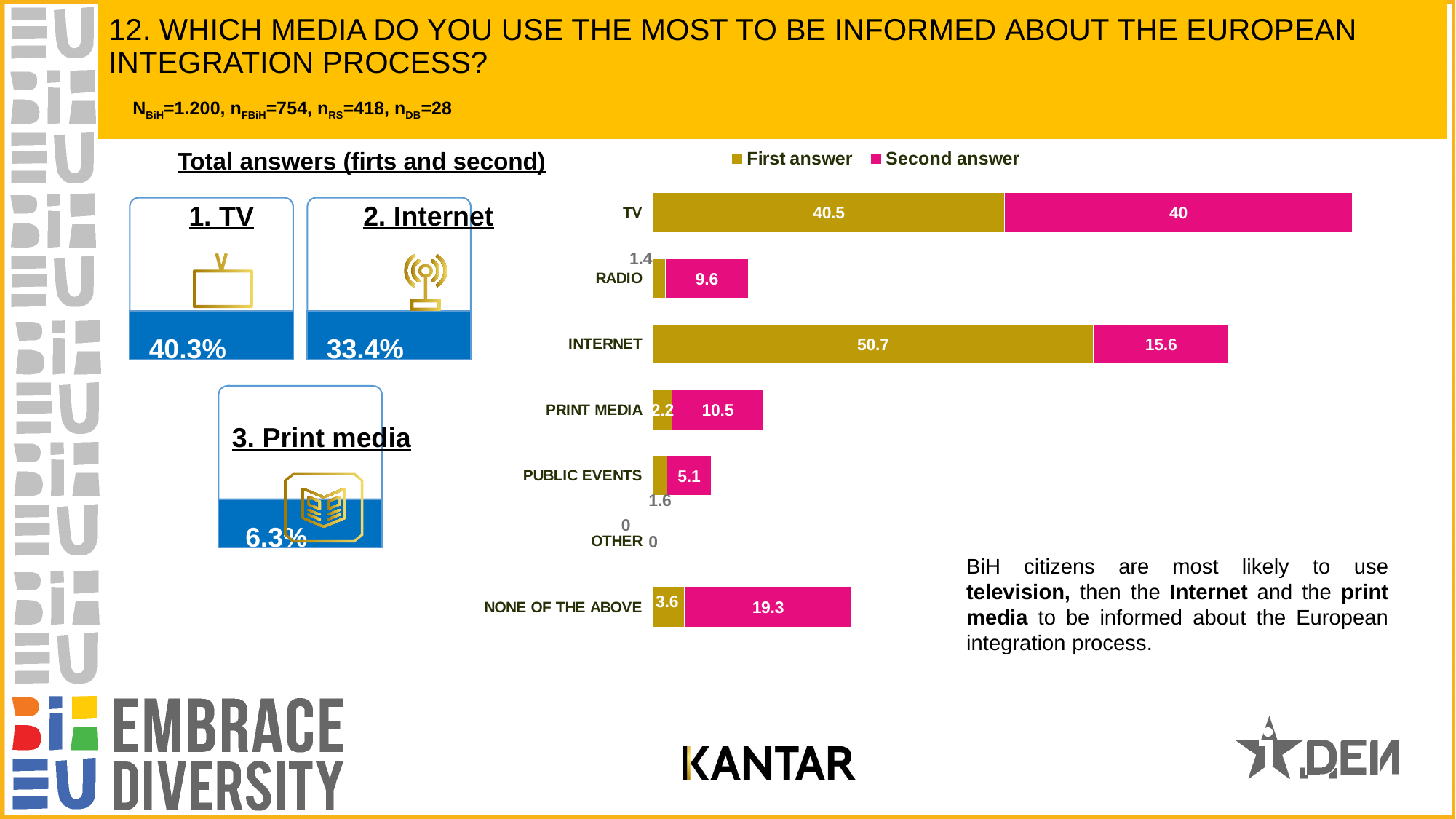
What is the Second answer value for None of the above? 19.3 What is the difference between the First answer values for Internet and TV? 10.2 Which category has the lowest Second answer value? Other What is the Second answer value for Radio? 9.6 What is the total of the stacked bar for TV (First answer plus Second answer)? 80.5 Which category has the highest First answer value? Internet How many categories are shown on the chart? 7 What kind of chart is shown on the slide? Stacked bar chart What is the First answer value for Internet? 50.7 How many series does the legend list? 2 Which is larger: the Second answer value for TV or the Second answer value for Internet? TV What is the First answer value for Print media? 2.2